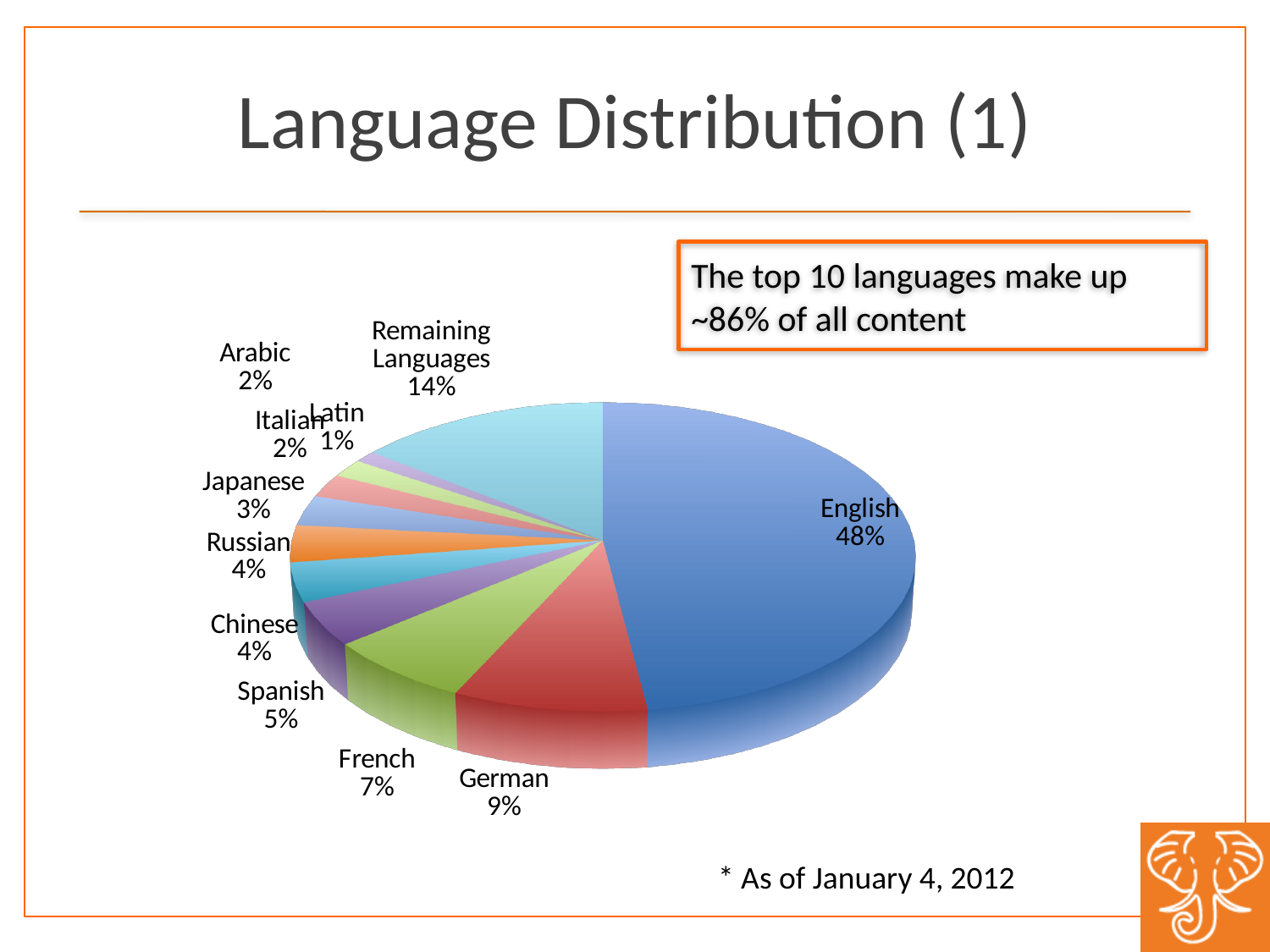
What percentage is shown for Remaining Languages? 14% Which has a larger share, French or Spanish? French What is the difference in percentage points between English and German? 39 What share of the pie does English have? 48% How many slices does the pie chart have? 11 Which language has the largest slice of the pie? English Which slice of the pie is the smallest? Latin What is the combined share of Japanese and Italian? 5% What percentage is shown for Latin? 1% What percentage is shown for German? 9% What is the title of the slide containing the chart? Language Distribution (1) What kind of chart is shown on the slide? pie chart